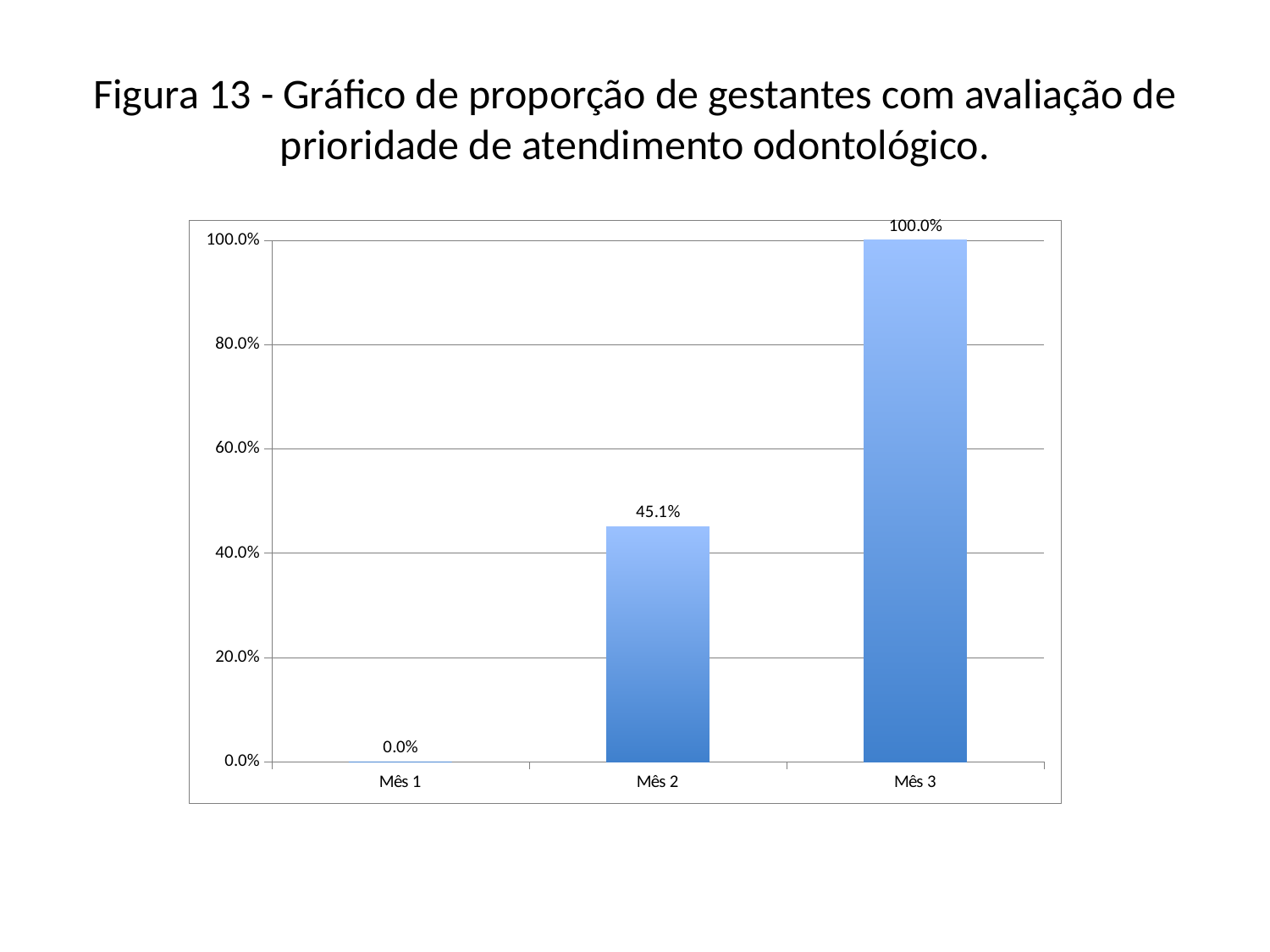
What is the value for Mês 3? 100.0% Is the value for Mês 2 greater or less than 40.0%? greater What is the value for Mês 2? 45.1% What kind of chart is shown on the slide? bar chart What is the figure number given in the slide title? Figura 13 Which month has the highest value? Mês 3 How many months are shown on the x axis? 3 Do the values rise or fall from Mês 1 to Mês 3? rise What is the value for Mês 1? 0.0% Which month has the lowest value? Mês 1 What is the difference between the values for Mês 3 and Mês 2? 54.9% Which is larger, the value for Mês 2 or the value for Mês 3? Mês 3